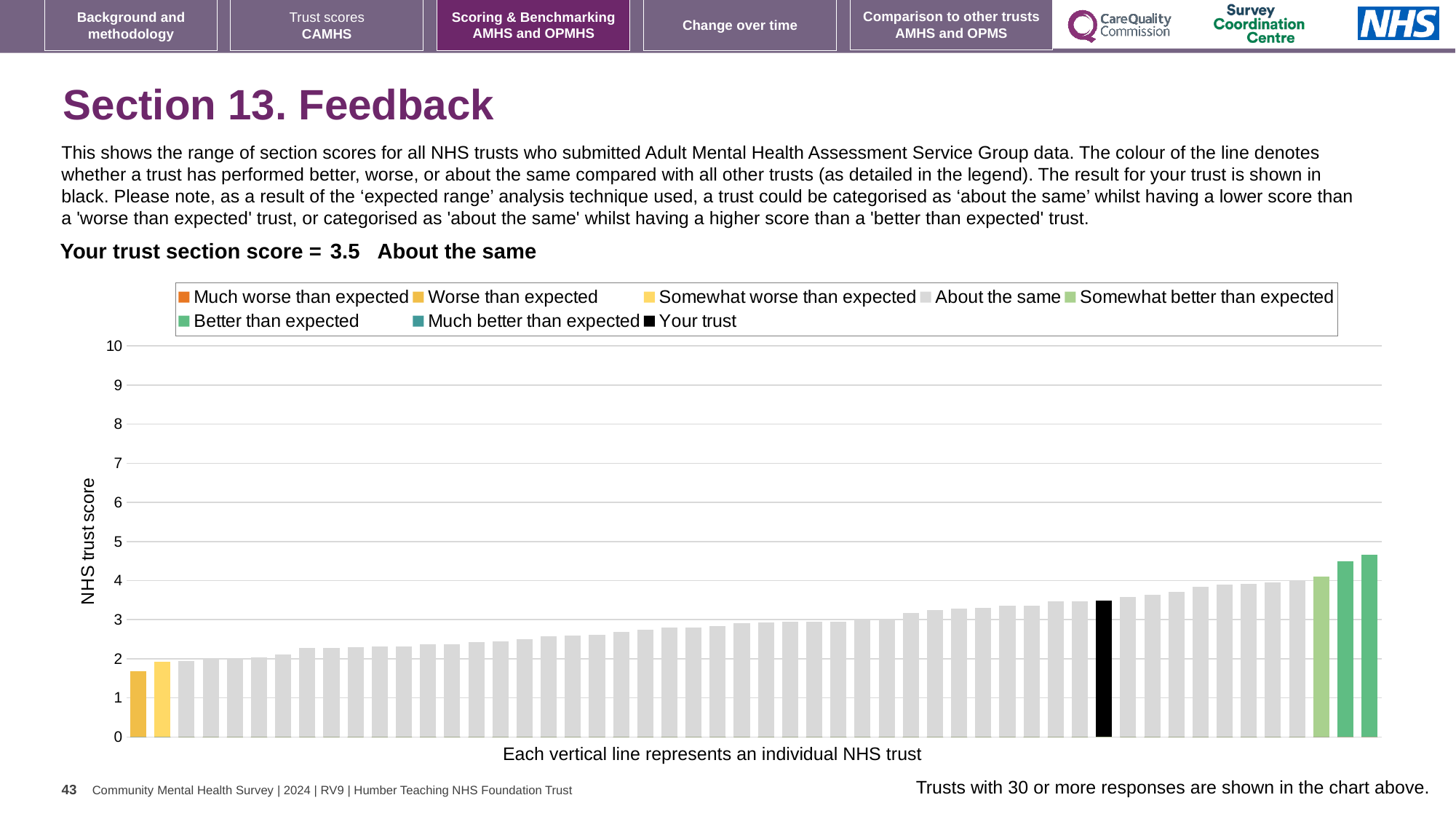
Is the value of the tallest bar greater or less than 4? greater Is the value of the shortest bar greater or less than 2? less Is the value for your trust greater or less than 4? less How many series does the legend list? 8 What colour is the bar representing your trust? black Is your trust's bar taller or shorter than the tallest bar in the chart? shorter Do the bar values rise or fall from left to right along the x axis? rise What is the label on the y axis of the chart? NHS trust score What is your trust's section score for Section 13. Feedback? 3.5 Which category is your trust placed in for Section 13. Feedback? About the same What kind of chart is shown on the slide? bar chart